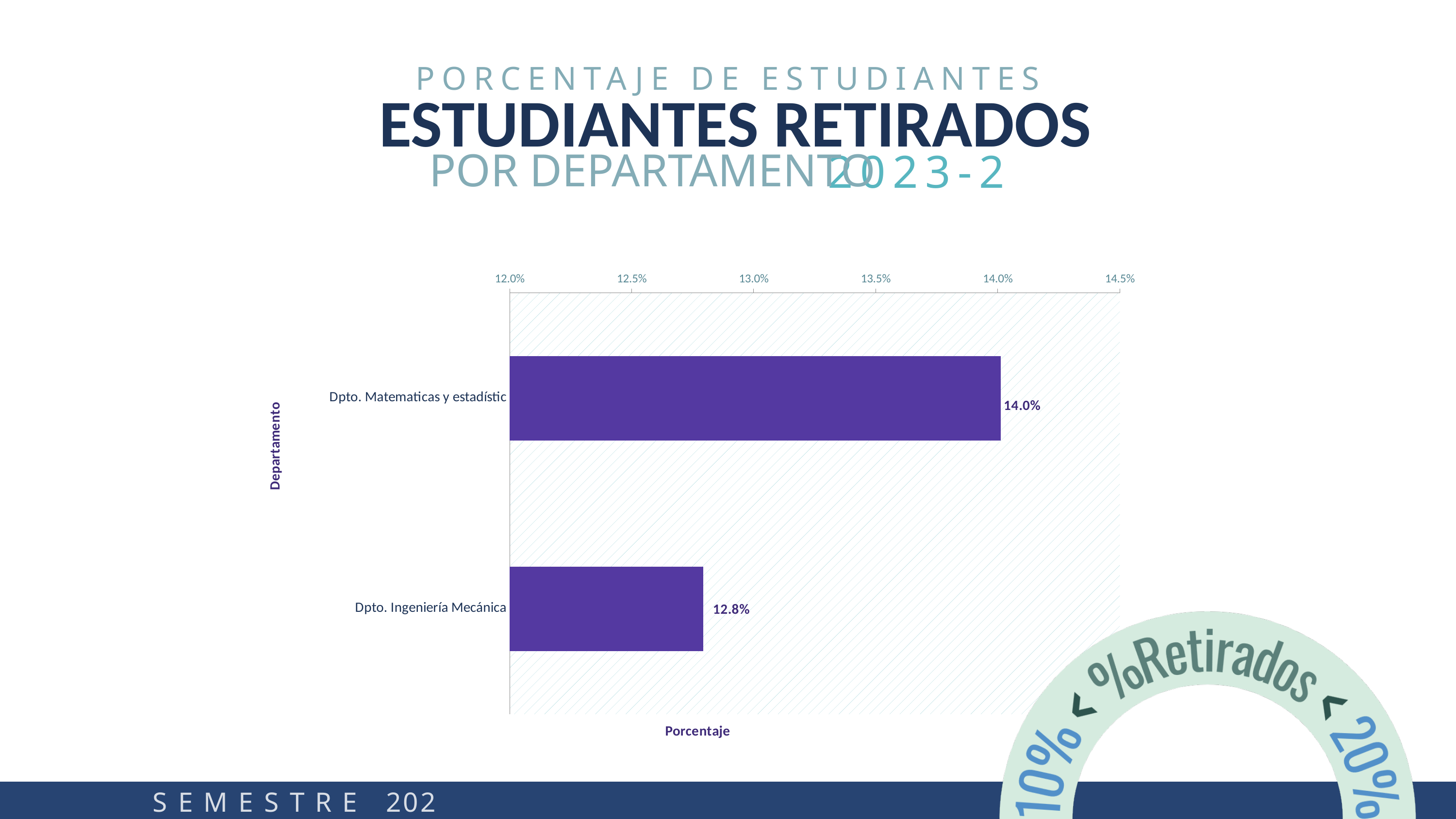
What is the value for Dpto. Matematicas y estadístic? 14.0% Which is larger, the value for Dpto. Ingeniería Mecánica or the value for Dpto. Matematicas y estadístic? Dpto. Matematicas y estadístic What kind of chart is shown on the slide? bar chart Is the value for Dpto. Ingeniería Mecánica greater or less than 13.0%? less Which department has the highest percentage? Dpto. Matematicas y estadístic What is the value for Dpto. Ingeniería Mecánica? 12.8% Which department has the lowest percentage? Dpto. Ingeniería Mecánica What is the difference between the values for Dpto. Matematicas y estadístic and Dpto. Ingeniería Mecánica? 1.2% Is the value for Dpto. Matematicas y estadístic greater or less than 13.5%? greater What is the label of the vertical axis? Departamento What is the label of the horizontal axis? Porcentaje How many departments are shown in the chart? 2